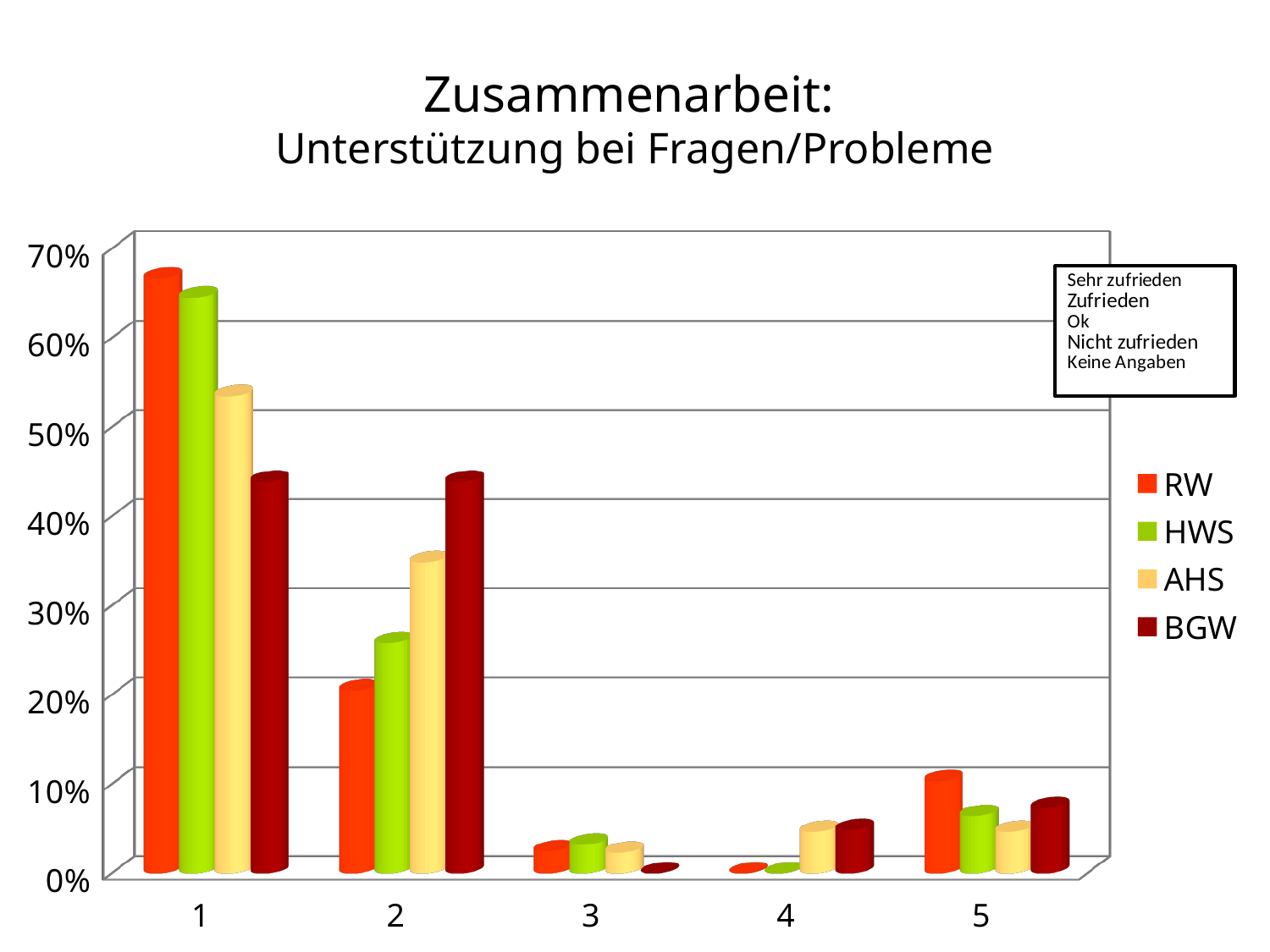
Is the value for HWS in category 2 greater or less than 30%? less In category 1, which is larger: RW or BGW? RW Is the value for RW in category 1 greater or less than 60%? greater For the RW series, which category has the highest value? 1 In category 2, which is larger: AHS or RW? AHS Is the value for AHS in category 1 greater or less than 50%? greater Which series are listed in the legend? RW, HWS, AHS, BGW In category 2, which series has the highest value? BGW How many categories are shown on the x axis? 5 How many series does the legend list? 4 What kind of chart is shown on the slide? bar chart